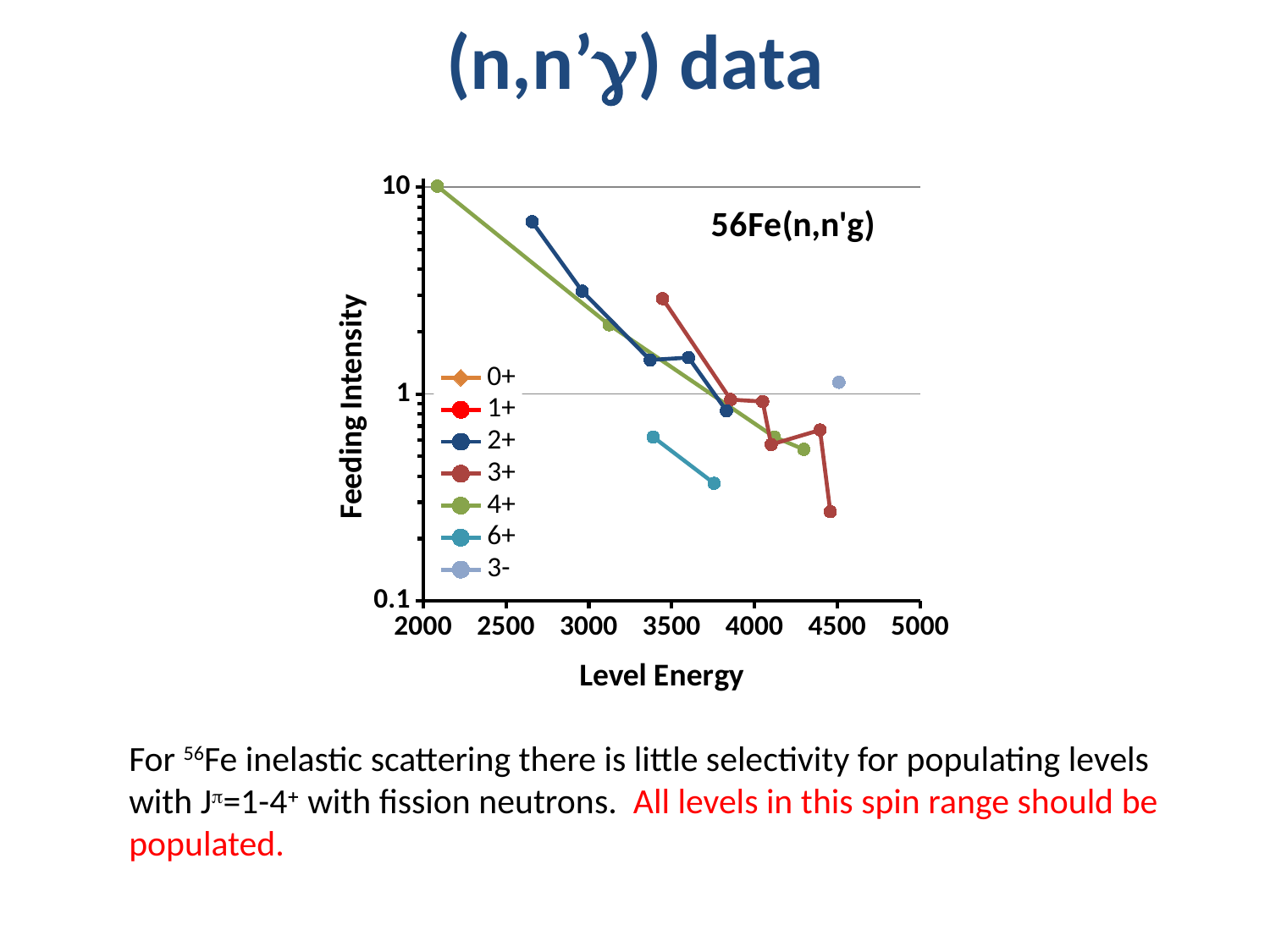
What is the label of the y axis? Feeding Intensity How many series does the legend list? 7 Is the feeding intensity of the first 2+ point (near level energy 2650) greater or less than 1? greater Which has the higher feeding intensity: the 3- point or the 6+ points? 3- How many data points are plotted for the 6+ series? 2 Is the feeding intensity of the 3- point greater or less than 1? greater Overall, do the feeding intensity values rise or fall as level energy increases? fall Which series contains the lowest feeding intensity point on the chart? 3+ What kind of chart is shown on the slide? line chart Which series reaches the highest feeding intensity on the chart? 4+ What is the title printed inside the chart? 56Fe(n,n'g) Are the feeding intensity values for the 6+ series greater or less than 1? less